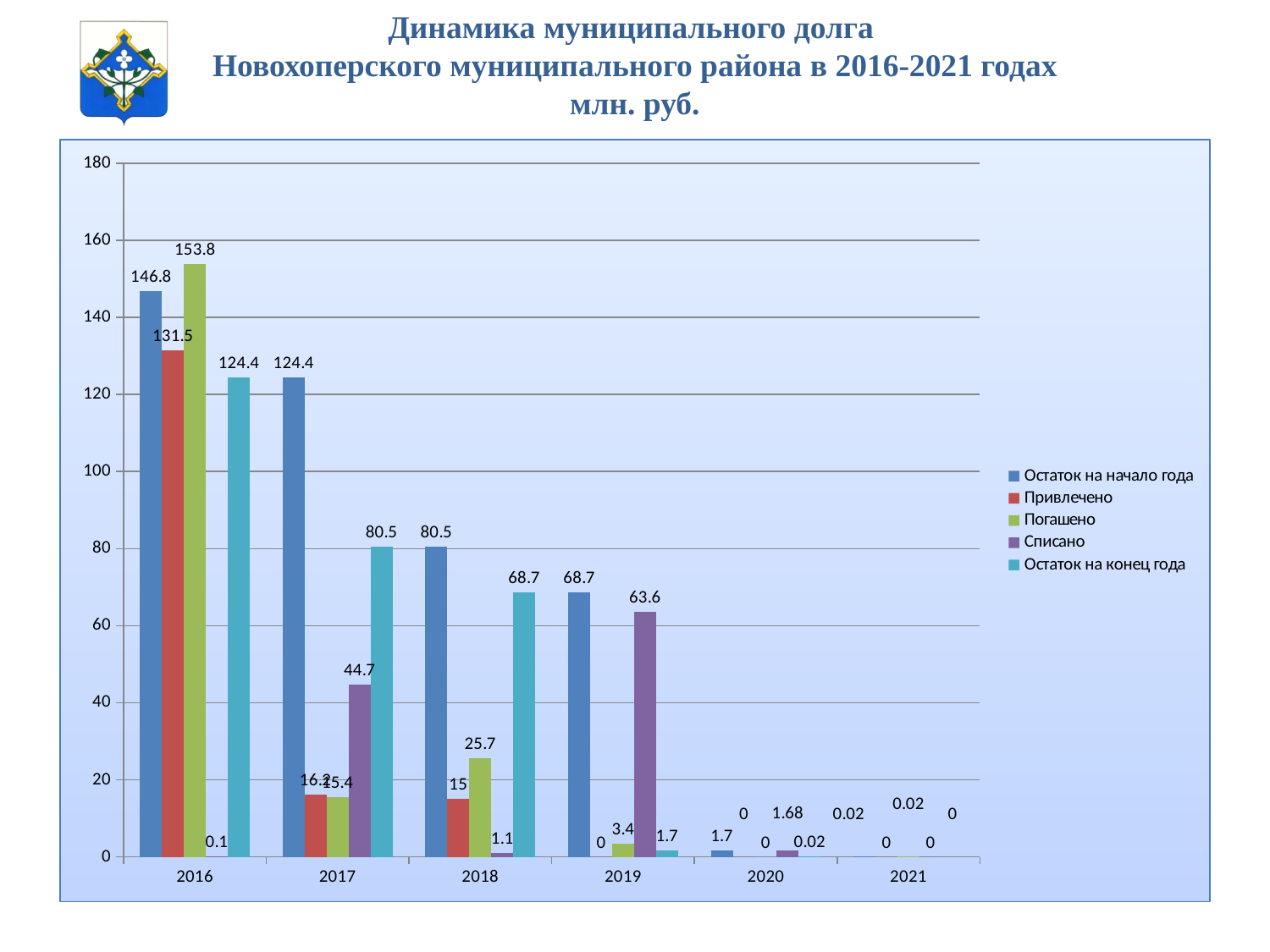
What is the difference between Остаток на начало года and Остаток на конец года in 2016? 22.4 What is the value of Списано for 2017? 44.7 What is the difference between Погашено and Привлечено in 2018? 10.7 How many years are shown on the x axis? 6 How many series does the legend list? 5 What kind of chart is shown on the slide? Bar chart What is the value of Привлечено for 2019? 0 Does Остаток на начало года rise or fall from 2016 to 2021? Fall What is the value of Погашено for 2016? 153.8 Which year has the larger value of Списано, 2017 or 2019? 2019 In which year is Остаток на начало года the highest? 2016 What is the value of Остаток на конец года for 2018? 68.7